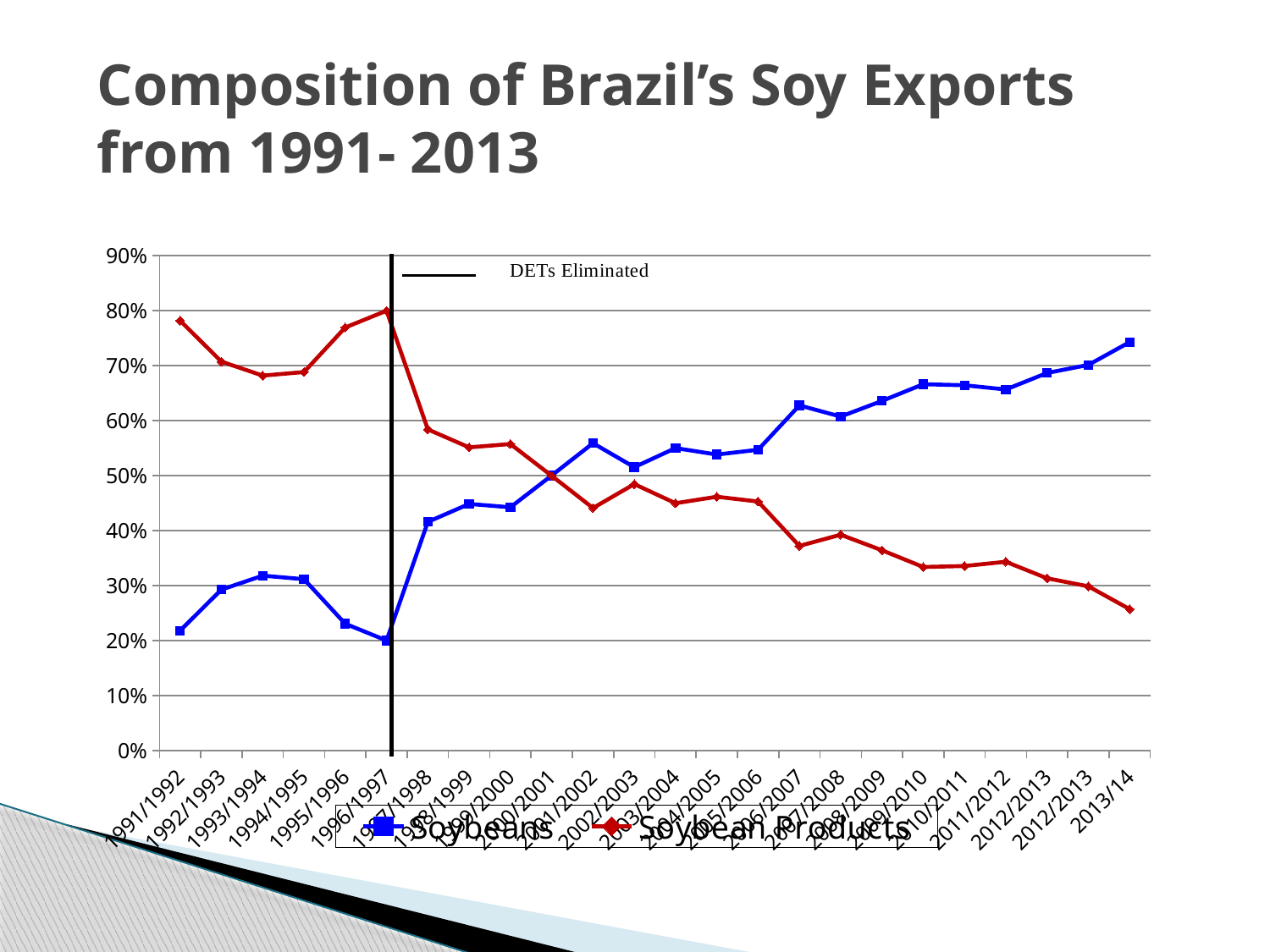
What is the title of the chart? Composition of Brazil's Soy Exports from 1991- 2013 How many series does the legend list? 2 In which period does the Soybeans series reach its highest value? 2013/14 Is the value for Soybeans in 2013/14 greater or less than 70%? greater In 1991/1992, which series has the higher value, Soybeans or Soybean Products? Soybean Products What label is attached to the vertical black line on the chart? DETs Eliminated Is the value for Soybeans in 1991/1992 greater or less than 30%? less In which period does the Soybean Products series reach its lowest value? 2013/14 What kind of chart is shown on the slide? Line chart Is the value for Soybean Products in 1991/1992 greater or less than 70%? greater Does the Soybean Products series generally rise or fall from 1991/1992 to 2013/14? Fall